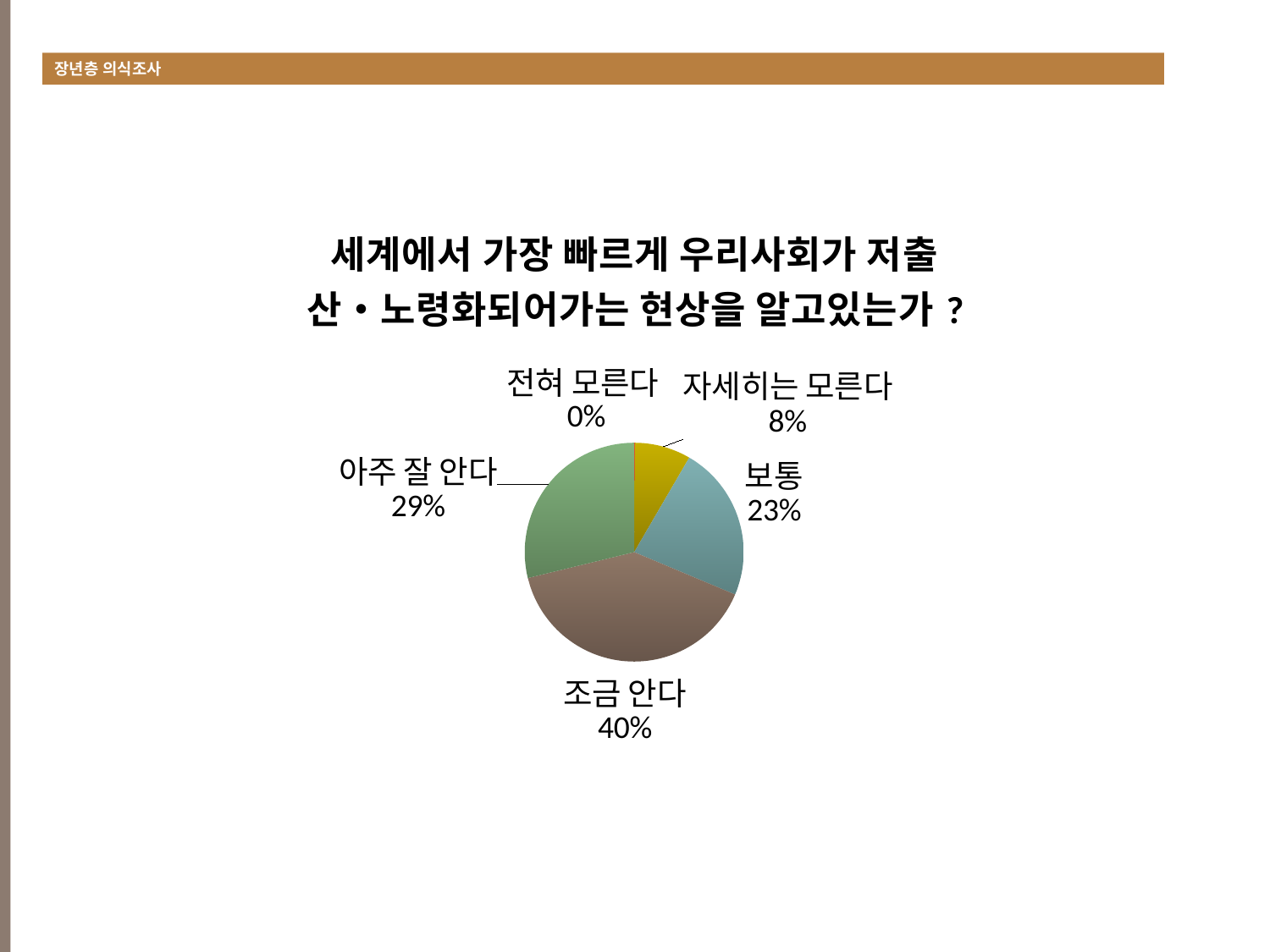
What percentage of respondents answered 조금 안다? 40% What is the difference in percentage points between 조금 안다 and 아주 잘 안다? 11 What percentage of respondents answered 보통? 23% Which response has the smallest share of the pie? 전혀 모른다 What percentage of respondents answered 전혀 모른다? 0% What is the title of the chart? 세계에서 가장 빠르게 우리사회가 저출산・노령화되어가는 현상을 알고있는가 ? How many response categories are labelled on the pie chart? 5 What percentage of respondents answered 아주 잘 안다? 29% What kind of chart is shown on the slide? pie chart What percentage of respondents answered 자세히는 모른다? 8% Which response has the largest share of the pie? 조금 안다 Which is larger, the share for 보통 or the share for 자세히는 모른다? 보통